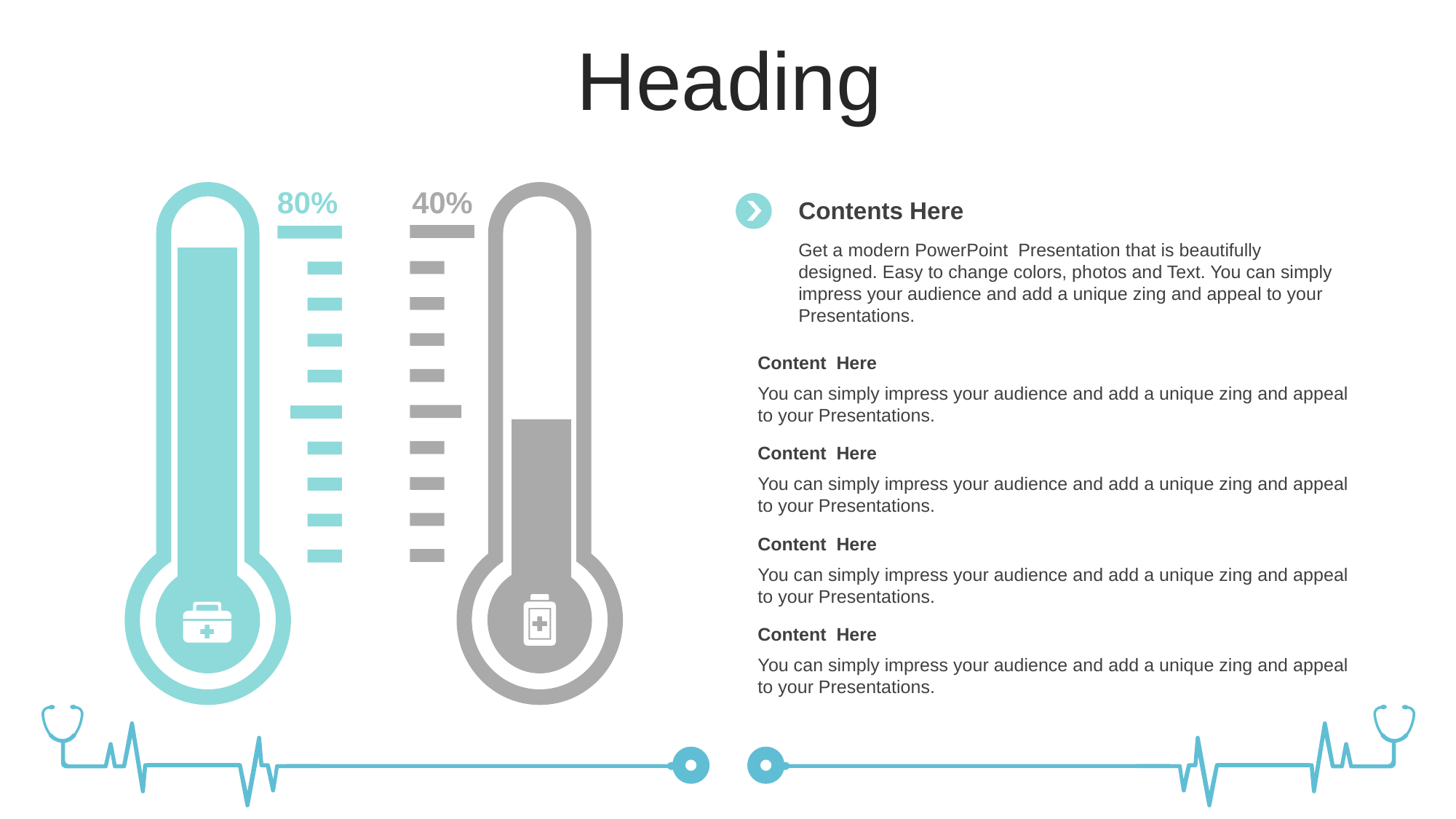
What value is shown for the left (teal) thermometer? 80% Is the value of the left thermometer larger or smaller than the value of the right thermometer? larger Which thermometer shows the higher value, the left teal one or the right gray one? the left teal one What kind of graphic is used to display the 80% and 40% values? thermometer gauges Which thermometer shows the lower value, the left teal one or the right gray one? the right gray one What colour is the thermometer showing 40%? gray What is the difference between the values of the left and right thermometers? 40% What colour is the thermometer showing 80%? teal What value is shown for the right (gray) thermometer? 40% How many thermometer gauges are shown on the slide? 2